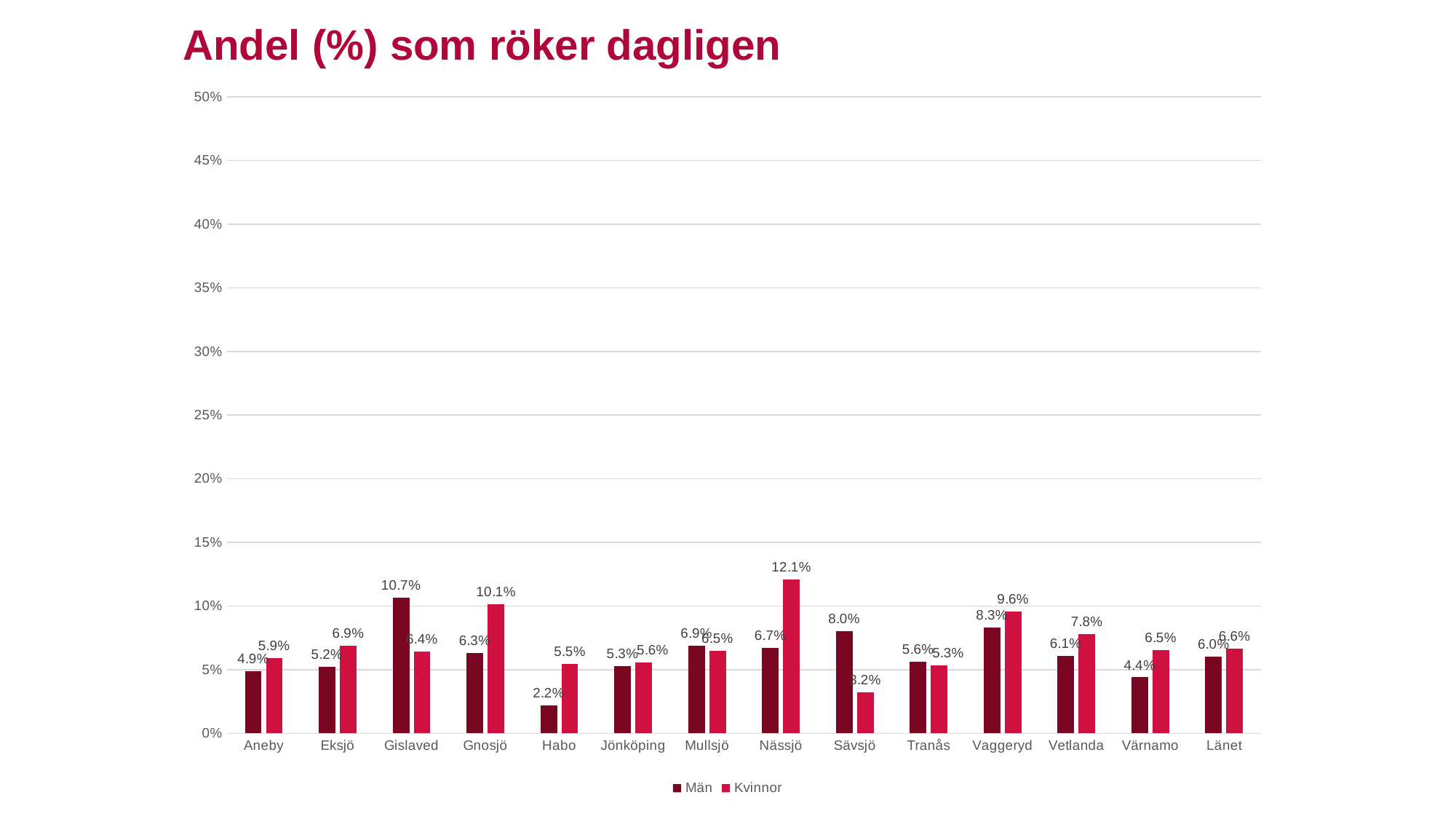
What is the value for Kvinnor in Länet? 6.6% Which category has the lowest value for Män? Habo What is the value for Kvinnor in Nässjö? 12.1% What is the title of the chart? Andel (%) som röker dagligen Which category has the highest value for Kvinnor? Nässjö What is the value for Män in Gislaved? 10.7% Is the value for Män in Habo greater or less than 5%? less What is the difference between the Kvinnor and Män values in Nässjö? 5.4 percentage points How many categories are shown on the x axis? 14 In Sävsjö, which is larger, the value for Män or for Kvinnor? Män How many series does the legend list? 2 What type of chart is shown on the slide? bar chart